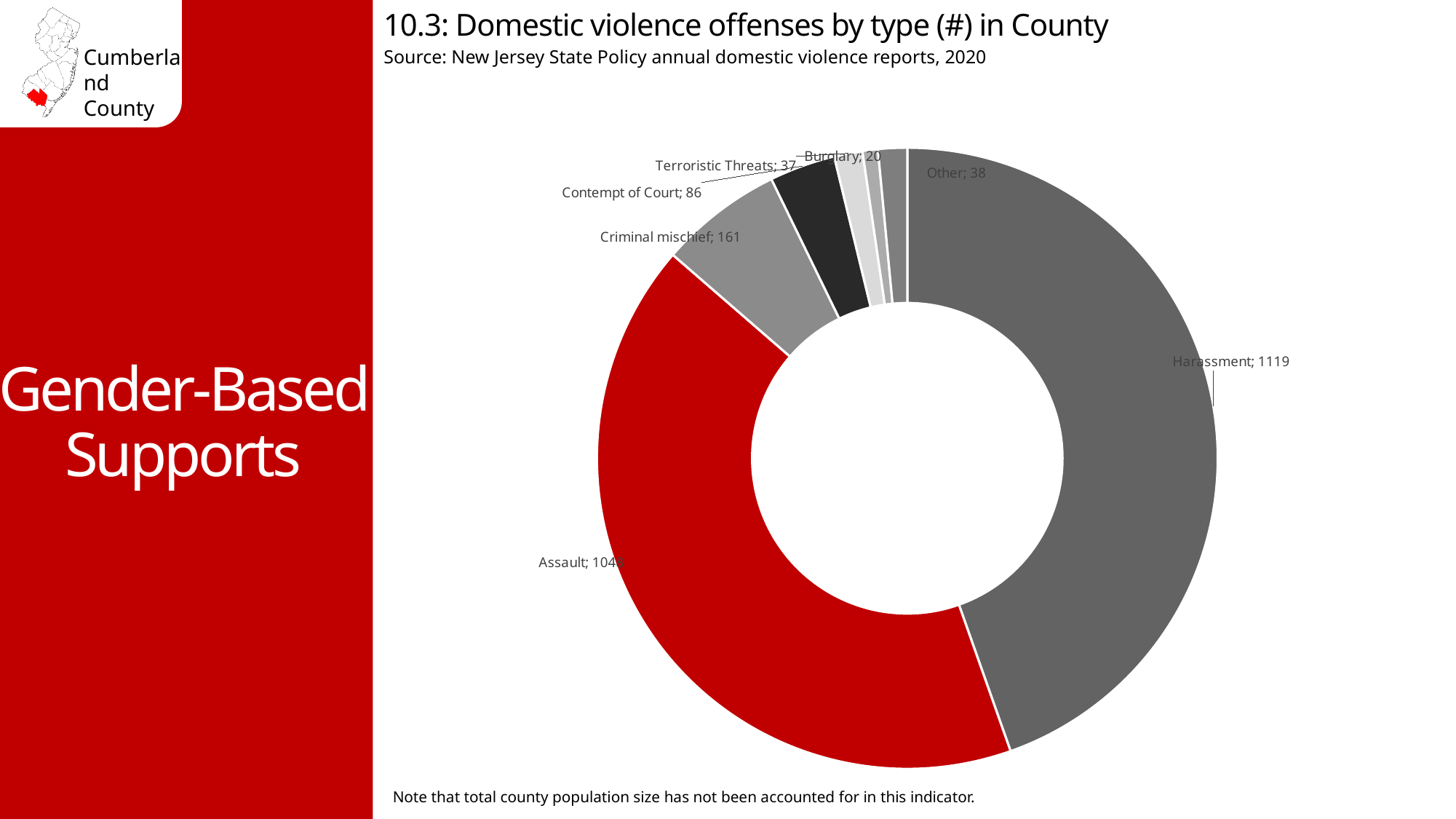
Which offense type has the highest number of offenses? Harassment What is the value for the Other category? 38 What is the value for Harassment in the domestic violence offenses chart? 1119 What is the value for Criminal mischief? 161 What is the value for Terroristic Threats? 37 Which is larger, Other or Terroristic Threats? Other What kind of chart is shown on the slide? doughnut chart Which labeled offense type has the lowest number of offenses? Burglary What is the value for Burglary? 20 What is the value for Contempt of Court? 86 What is the difference between Criminal mischief and Contempt of Court? 75 What colour is the Assault slice? red